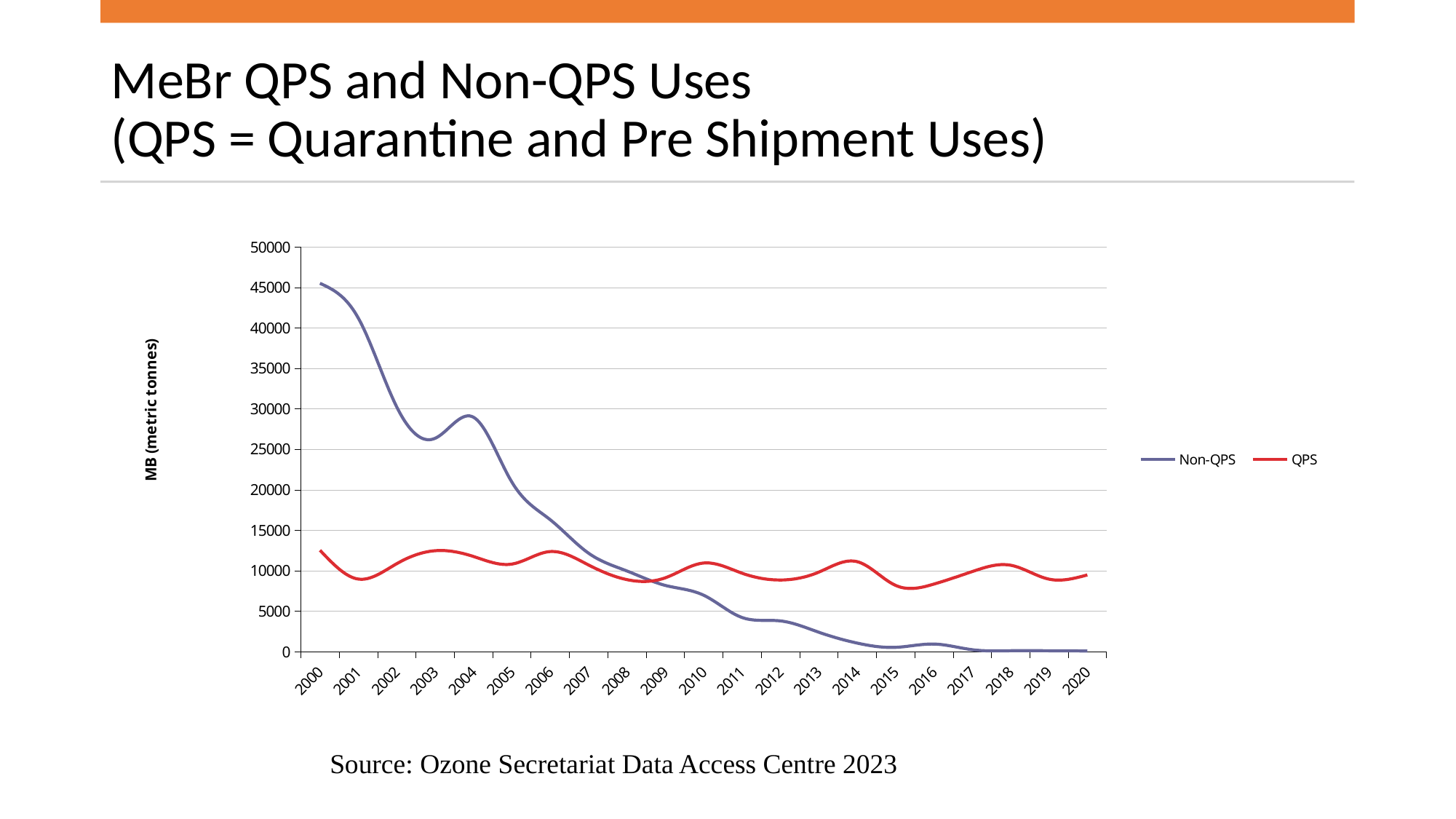
How many years are plotted along the x axis? 21 Does the Non-QPS series rise or fall from 2000 to 2020? fall How many series does the legend list? 2 What is the label on the vertical axis of the chart? MB (metric tonnes) Is the QPS value for 2015 greater or less than 10000? less In which year is the Non-QPS value highest? 2000 In 2012, which series has the larger value, Non-QPS or QPS? QPS In 2000, which series has the larger value, Non-QPS or QPS? Non-QPS Is the Non-QPS value for 2010 greater or less than 10000? less What kind of chart is shown on the slide? line chart Is the Non-QPS value for 2000 greater or less than 40000? greater